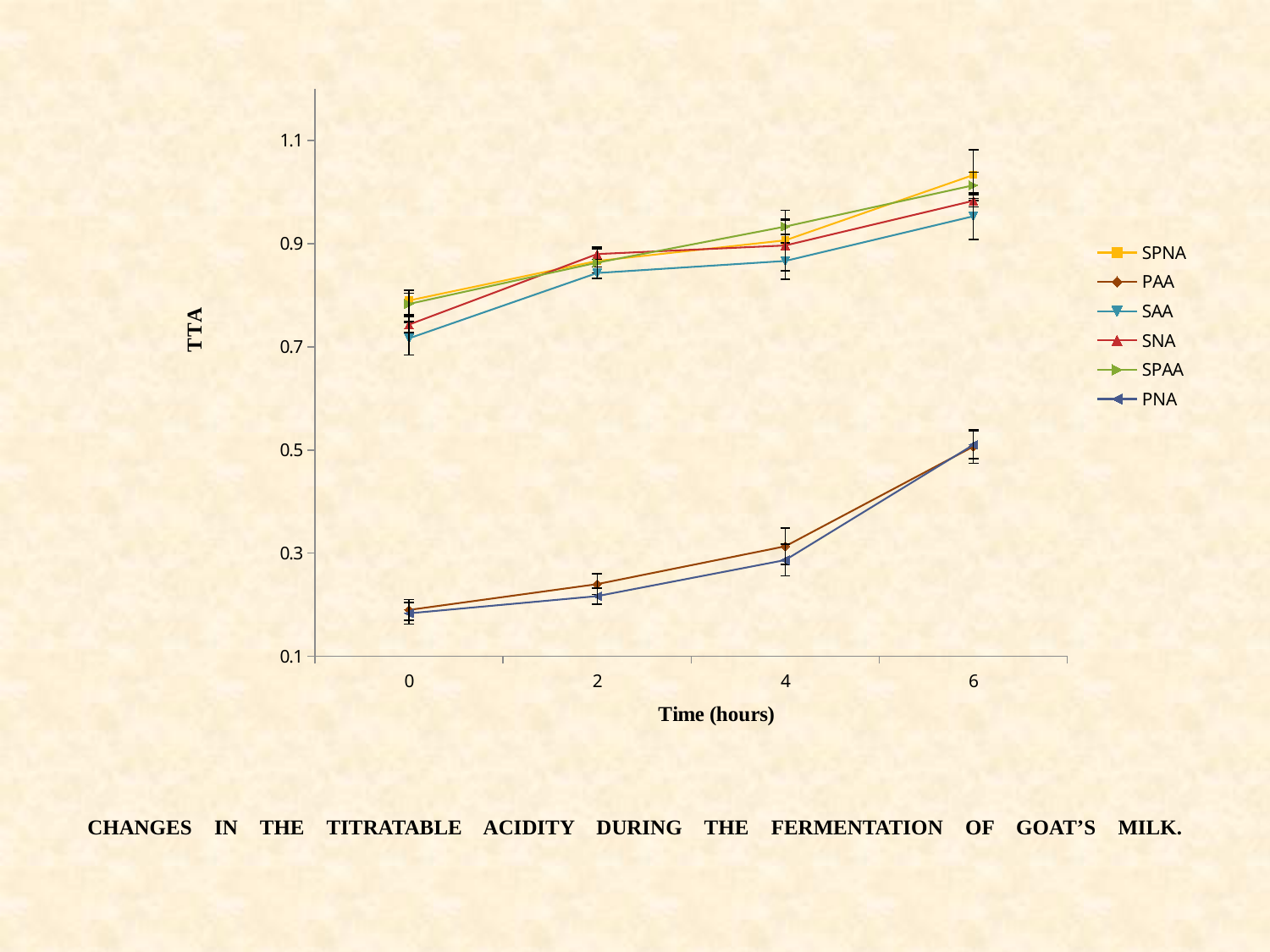
What kind of chart is shown on the slide? Line chart Is the value for SAA at 2 hours greater or less than 0.7? greater At 0 hours, which has the larger TTA value, SAA or PNA? SAA Does the TTA value for PAA rise or fall as time increases from 0 to 6 hours? Rise Is the value for PAA at 0 hours greater or less than 0.3? less How many series does the legend list? 6 Does the TTA value for SPNA rise or fall between 0 and 6 hours? Rise How many time points are plotted along the x axis? 4 What is the title of the x axis? Time (hours) Is the value for SPNA at 6 hours greater or less than 0.9? greater At 6 hours, which has the larger TTA value, SPNA or PAA? SPNA